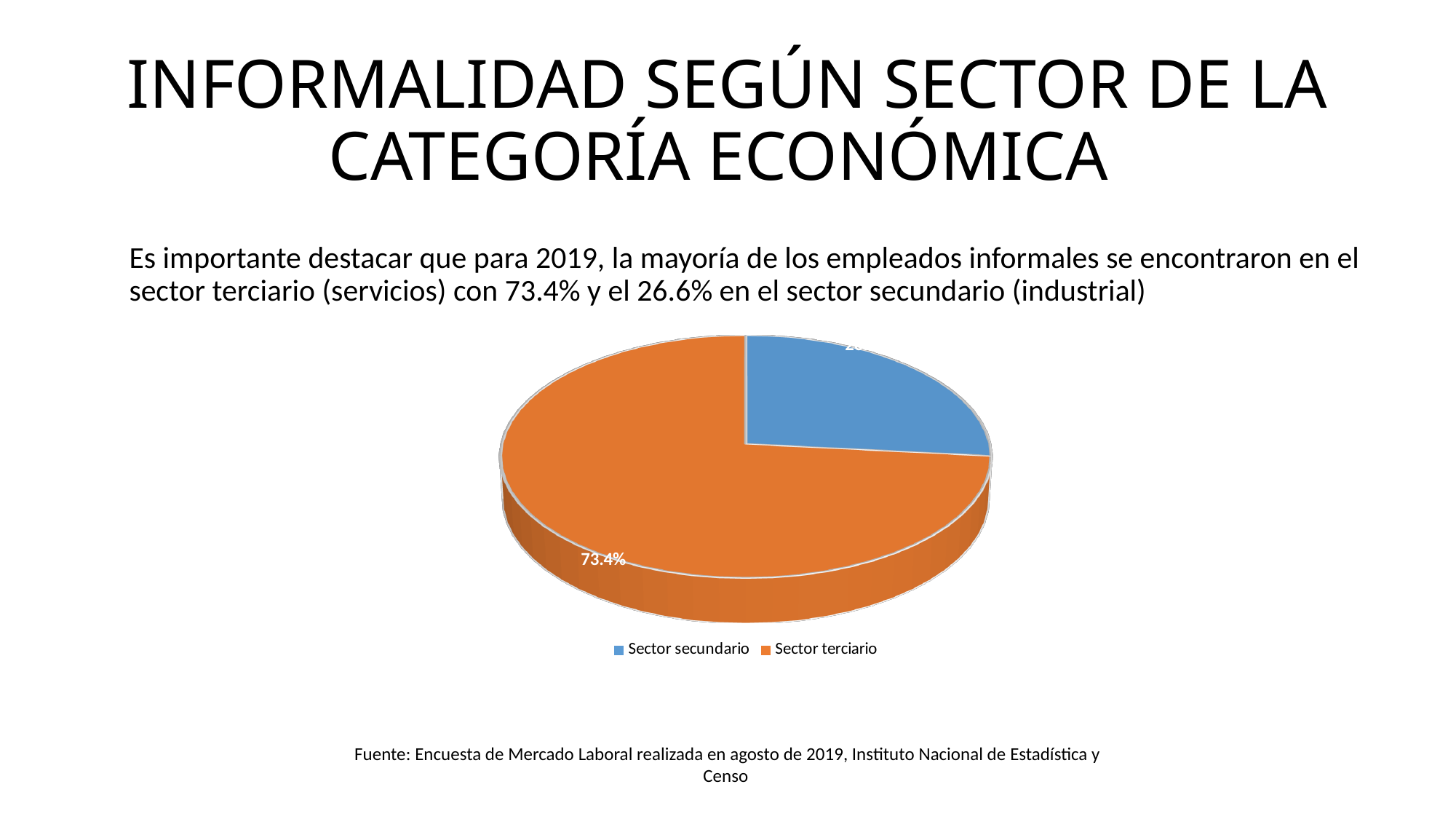
How many slices does the pie chart have? 2 Which is larger, the slice for Sector secundario or the slice for Sector terciario? Sector terciario What share of the pie does Sector secundario have, according to the slide? 26.6% What is the difference in percentage points between the Sector terciario share and the Sector secundario share? 46.8 How many entries does the legend list? 2 Which sector has the smallest slice of the pie? Sector secundario What kind of chart is shown on the slide? Pie chart What share of the pie does Sector terciario have? 73.4% What colour is the Sector terciario slice? Orange Which sector has the largest slice of the pie? Sector terciario What colour is the Sector secundario slice? Blue